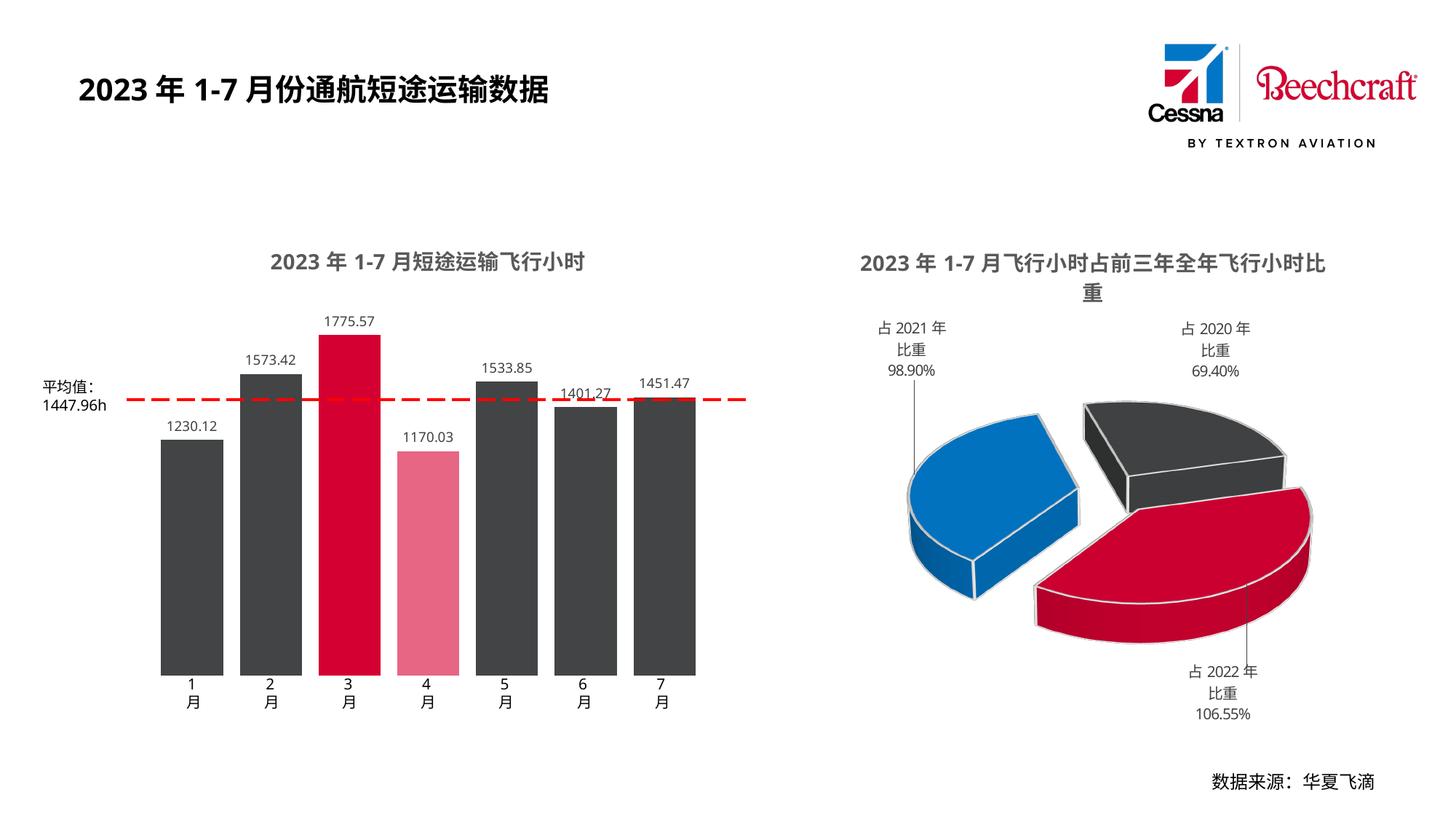
In the bar chart "2023 年 1-7 月短途运输飞行小时", what is the value for 1 月? 1230.12 In the pie chart "2023 年 1-7 月飞行小时占前三年全年飞行小时比重", how many slices are there? 3 In the bar chart "2023 年 1-7 月短途运输飞行小时", what is the difference between the values for 3 月 and 4 月? 605.54 In the bar chart "2023 年 1-7 月短途运输飞行小时", which is larger, the value for 2 月 or the value for 5 月? 2 月 In the bar chart "2023 年 1-7 月短途运输飞行小时", which month has the lowest value? 4 月 What kind of chart is the chart on the left of the slide? bar chart In the bar chart "2023 年 1-7 月短途运输飞行小时", how many months are plotted? 7 In the pie chart "2023 年 1-7 月飞行小时占前三年全年飞行小时比重", which slice has the smallest value? 占 2020 年比重 In the bar chart "2023 年 1-7 月短途运输飞行小时", which month has the highest value? 3 月 In the bar chart "2023 年 1-7 月短途运输飞行小时", what average value is marked by the dashed line? 1447.96h In the pie chart "2023 年 1-7 月飞行小时占前三年全年飞行小时比重", what is the value for 占 2022 年比重? 106.55% In the bar chart "2023 年 1-7 月短途运输飞行小时", what is the value for 3 月? 1775.57